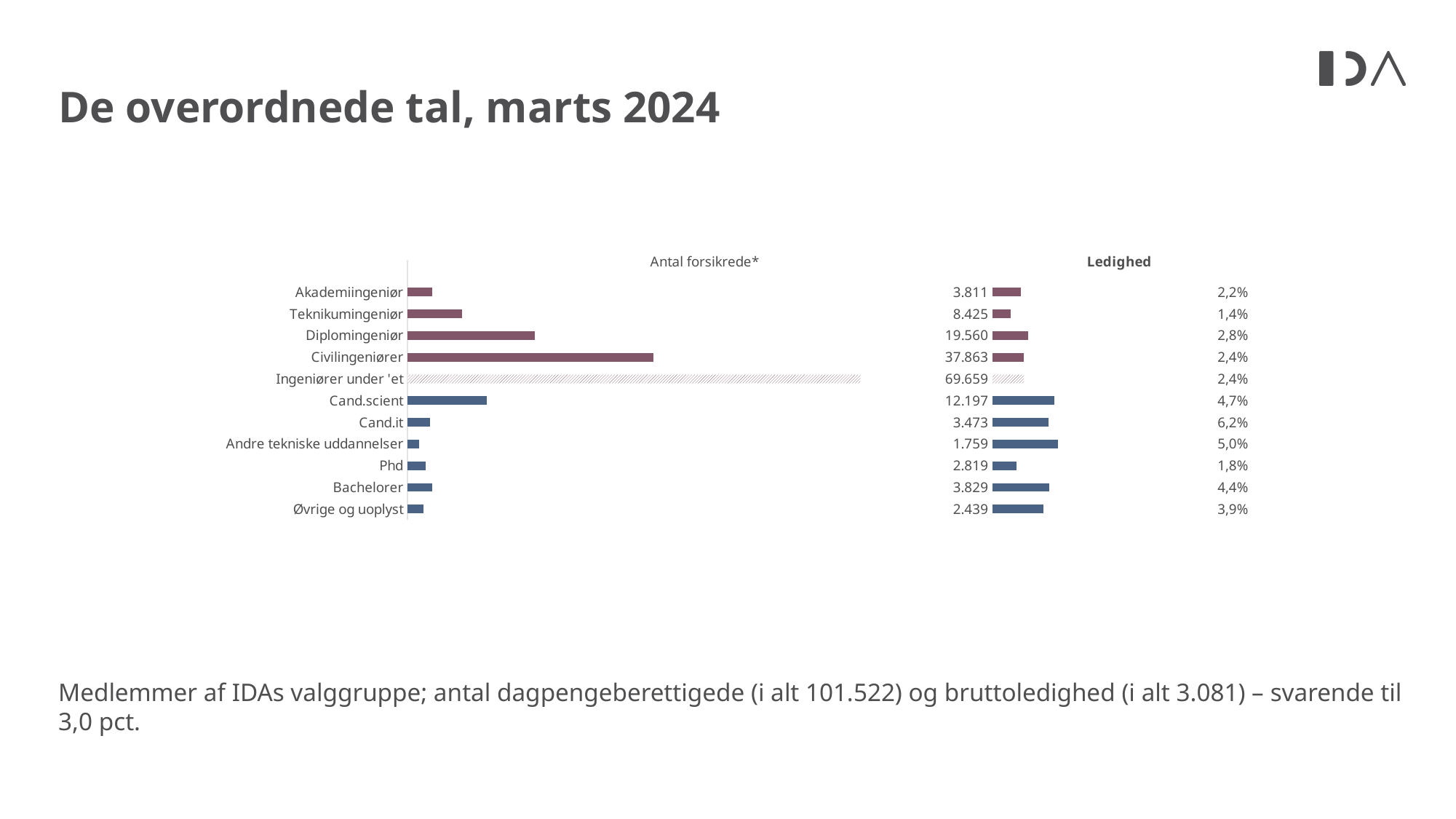
How many categories are shown in the 'Antal forsikrede*' chart? 11 In the 'Antal forsikrede*' chart, which is larger: Phd or Bachelorer? Bachelorer In the 'Antal forsikrede*' chart, what is the value for Civilingeniører? 37.863 In the 'Ledighed' chart, what is the value for Cand.it? 6,2% In the 'Ledighed' chart, which category has the highest value? Cand.it In the 'Antal forsikrede*' chart, which category has the lowest value? Andre tekniske uddannelser In the 'Antal forsikrede*' chart, what is the value for Andre tekniske uddannelser? 1.759 What kind of chart is the 'Ledighed' chart? Bar chart In the 'Ledighed' chart, which is larger: Cand.scient or Bachelorer? Cand.scient In the 'Ledighed' chart, what is the value for Ingeniører under 'et? 2,4% In the 'Ledighed' chart, which category has the lowest value? Teknikumingeniør In the 'Antal forsikrede*' chart, what is the difference between Diplomingeniør and Teknikumingeniør? 11.135